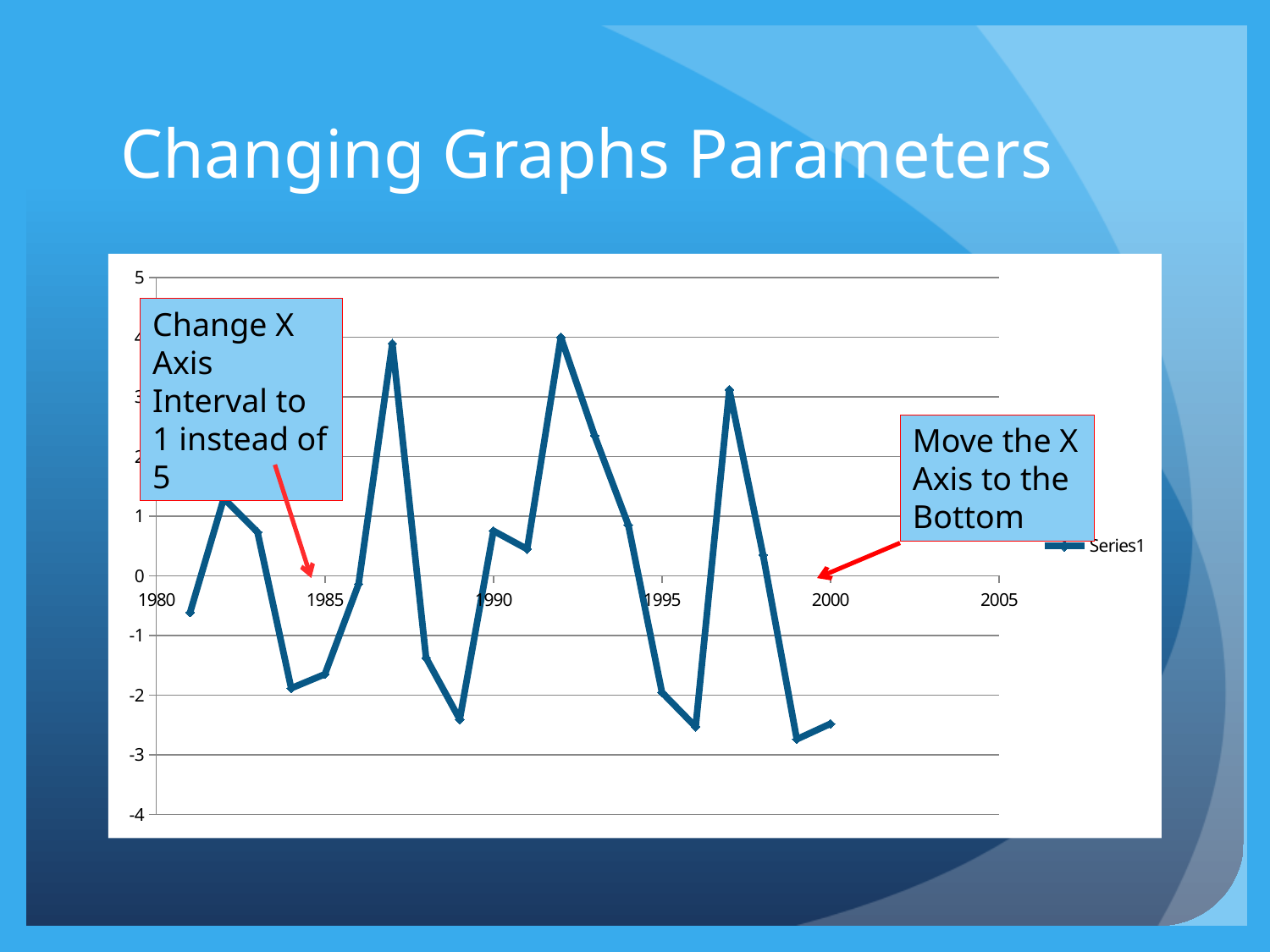
Is the value for 1996 greater or less than -2? less Which has the larger value, 1992 or 1997? 1992 Is the value for 1997 greater or less than 2? greater What kind of chart is shown on the slide? line chart Is the value for 1982 greater or less than 0? greater Do the values rise or fall from 1997 to 1999? fall What is the name of the series shown in the chart's legend? Series1 What are the lowest and highest values shown on the chart's y axis? -4 and 5 How many series does the chart's legend list? 1 Which has the larger value, 1987 or 1983? 1987